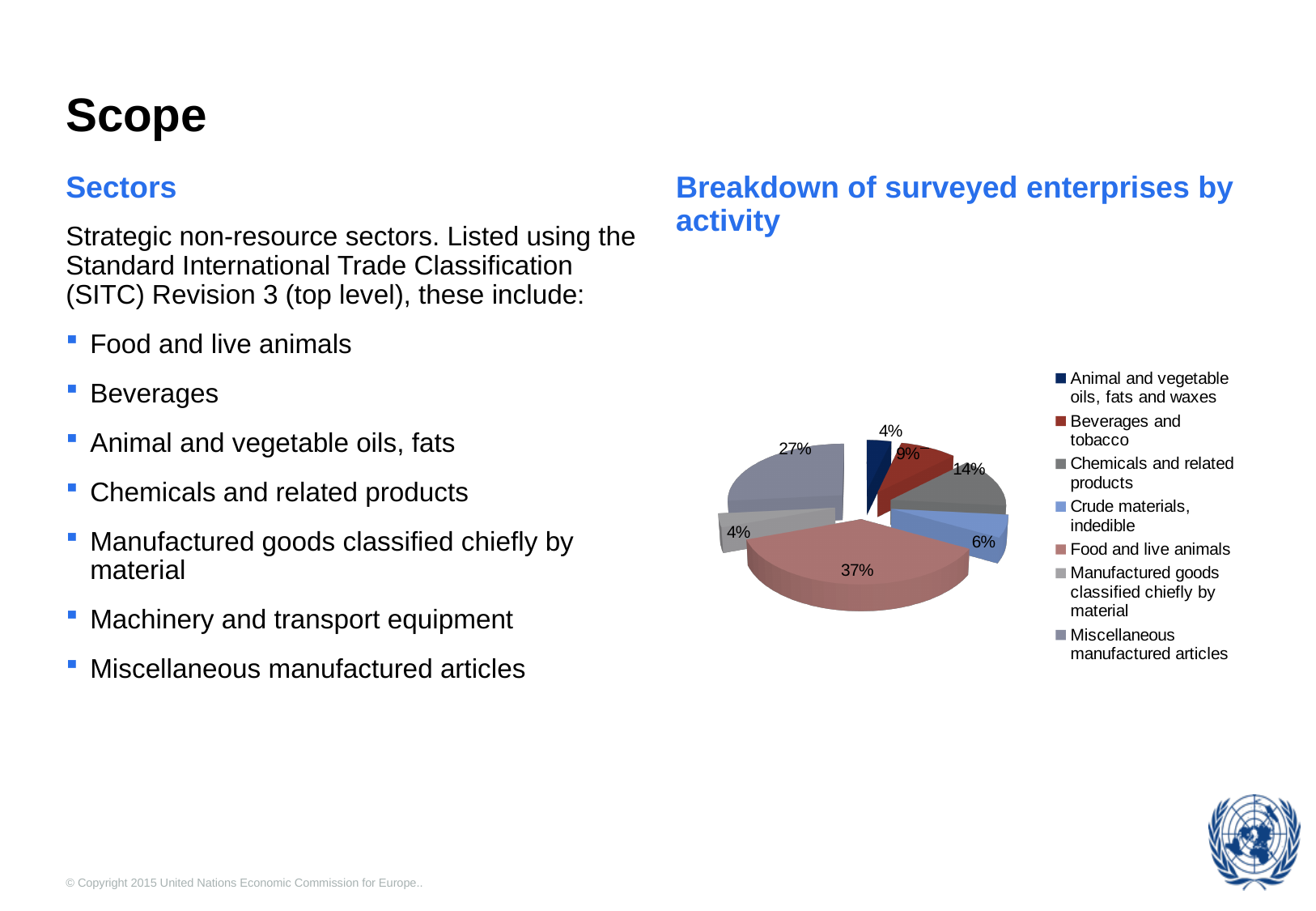
What share of surveyed enterprises is in Chemicals and related products? 14% What is the title of the chart? Breakdown of surveyed enterprises by activity What share of surveyed enterprises is in Food and live animals? 37% What is the difference in percentage points between Food and live animals and Miscellaneous manufactured articles? 10 percentage points What is the combined share of Animal and vegetable oils, fats and waxes and Manufactured goods classified chiefly by material? 8% Which activity accounts for the largest share of surveyed enterprises? Food and live animals How many activity categories does the legend list? 7 Which has a larger share, Chemicals and related products or Beverages and tobacco? Chemicals and related products What share of surveyed enterprises is in Crude materials, indedible? 6% What type of chart is shown on the slide? Pie chart What share of surveyed enterprises is in Miscellaneous manufactured articles? 27% What share of surveyed enterprises is in Beverages and tobacco? 9%